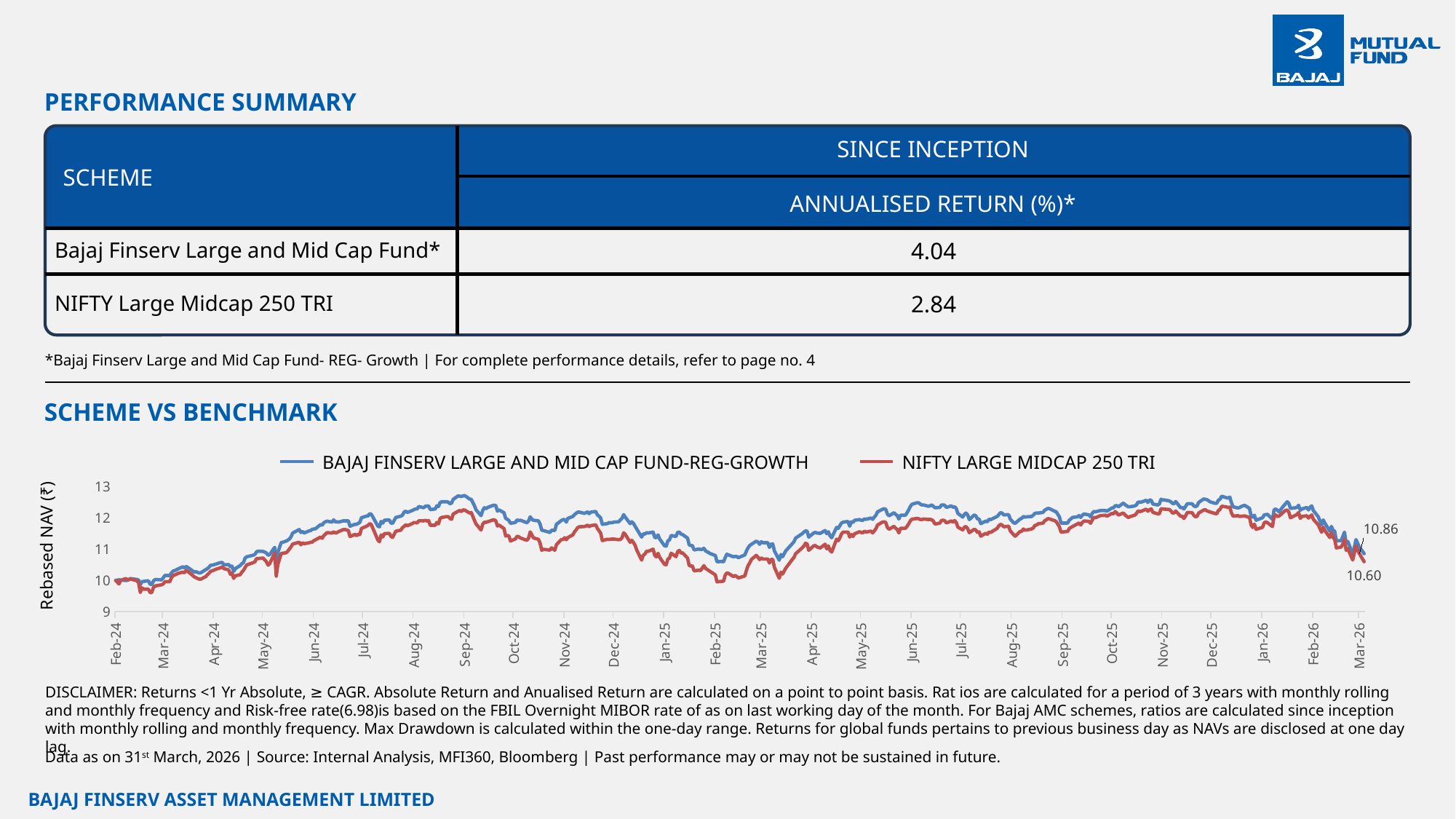
In the 'Scheme vs Benchmark' chart, what is the difference between the final labelled values of the fund (10.86) and the benchmark (10.60)? 0.26 In the 'Scheme vs Benchmark' chart, what is the final labelled value for NIFTY LARGE MIDCAP 250 TRI? 10.60 What is the label on the vertical axis of the 'Scheme vs Benchmark' chart? Rebased NAV (₹) In the 'Scheme vs Benchmark' chart, do the values for both series rise or fall from Feb-26 to Mar-26? fall In the 'Scheme vs Benchmark' chart, is the value for NIFTY LARGE MIDCAP 250 TRI around Feb-25 greater or less than 11? less In the 'Scheme vs Benchmark' chart, which series ends higher at Mar-26: BAJAJ FINSERV LARGE AND MID CAP FUND-REG-GROWTH or NIFTY LARGE MIDCAP 250 TRI? BAJAJ FINSERV LARGE AND MID CAP FUND-REG-GROWTH How many series does the legend of the 'Scheme vs Benchmark' chart list? 2 What kind of chart is shown under 'Scheme vs Benchmark'? line chart In the 'Scheme vs Benchmark' chart, is the value for BAJAJ FINSERV LARGE AND MID CAP FUND-REG-GROWTH around Sep-24 greater or less than 12? greater In the 'Scheme vs Benchmark' chart, do the values for BAJAJ FINSERV LARGE AND MID CAP FUND-REG-GROWTH generally rise or fall from Feb-24 to Sep-24? rise In the 'Scheme vs Benchmark' chart, which colour represents NIFTY LARGE MIDCAP 250 TRI? red In the 'Scheme vs Benchmark' chart, what is the final labelled value for BAJAJ FINSERV LARGE AND MID CAP FUND-REG-GROWTH? 10.86